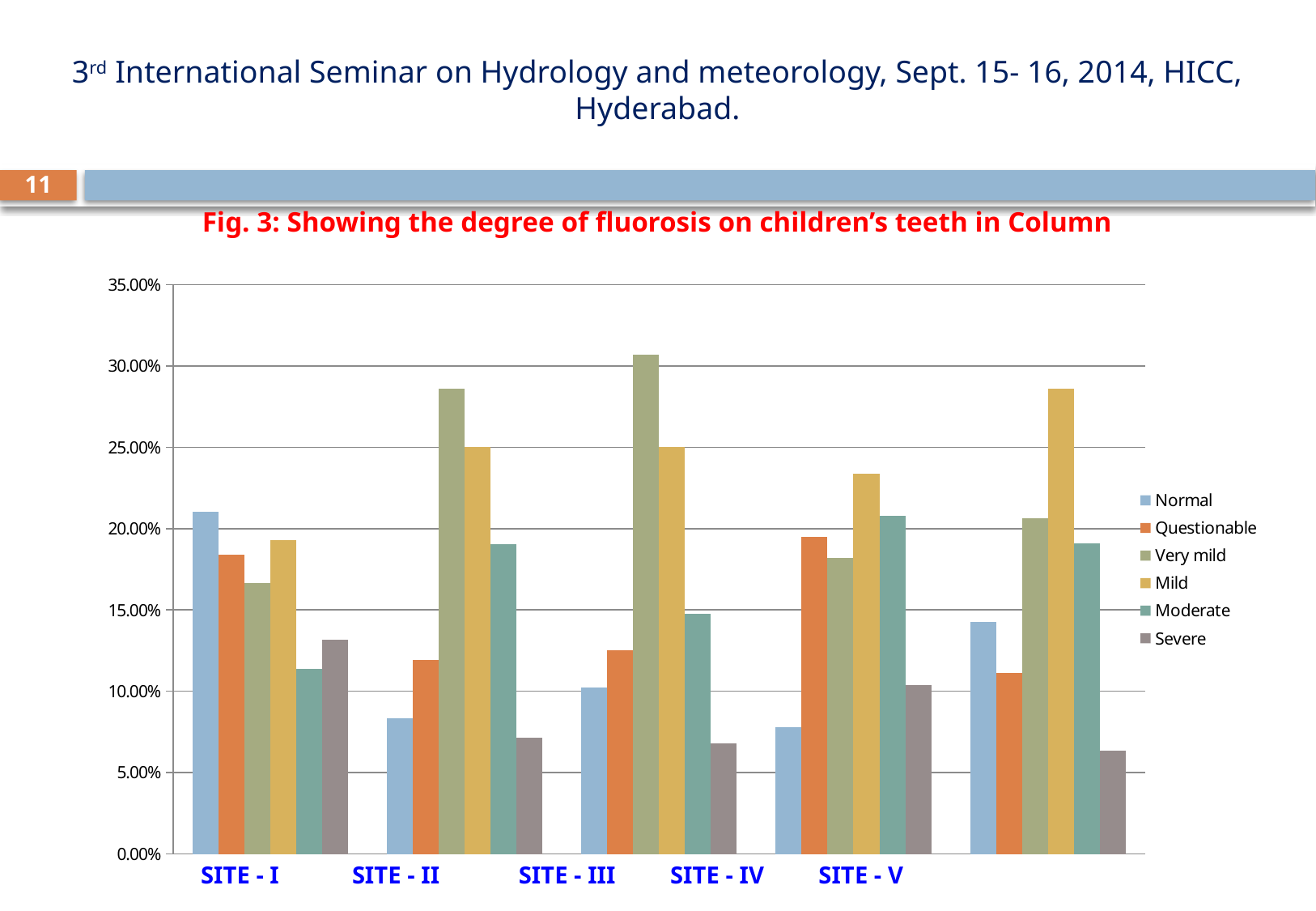
Which site has the larger Normal value, SITE - I or SITE - II? SITE - I Which series has the highest value at SITE - I? Normal Which series has the lowest value at SITE - III? Severe Is the value for Severe at SITE - V greater or less than 10.00%? less Is the value for Very mild at SITE - III greater or less than 25.00%? greater Is the value for Normal at SITE - II greater or less than 10.00%? less What are the series names listed in the legend? Normal, Questionable, Very mild, Mild, Moderate, Severe How many series does the legend list? 6 What kind of chart is shown on the slide? bar chart At SITE - IV, which is larger, Mild or Moderate? Mild Which series has the highest value at SITE - II? Very mild What is the title of the chart? Fig. 3: Showing the degree of fluorosis on children's teeth in Column